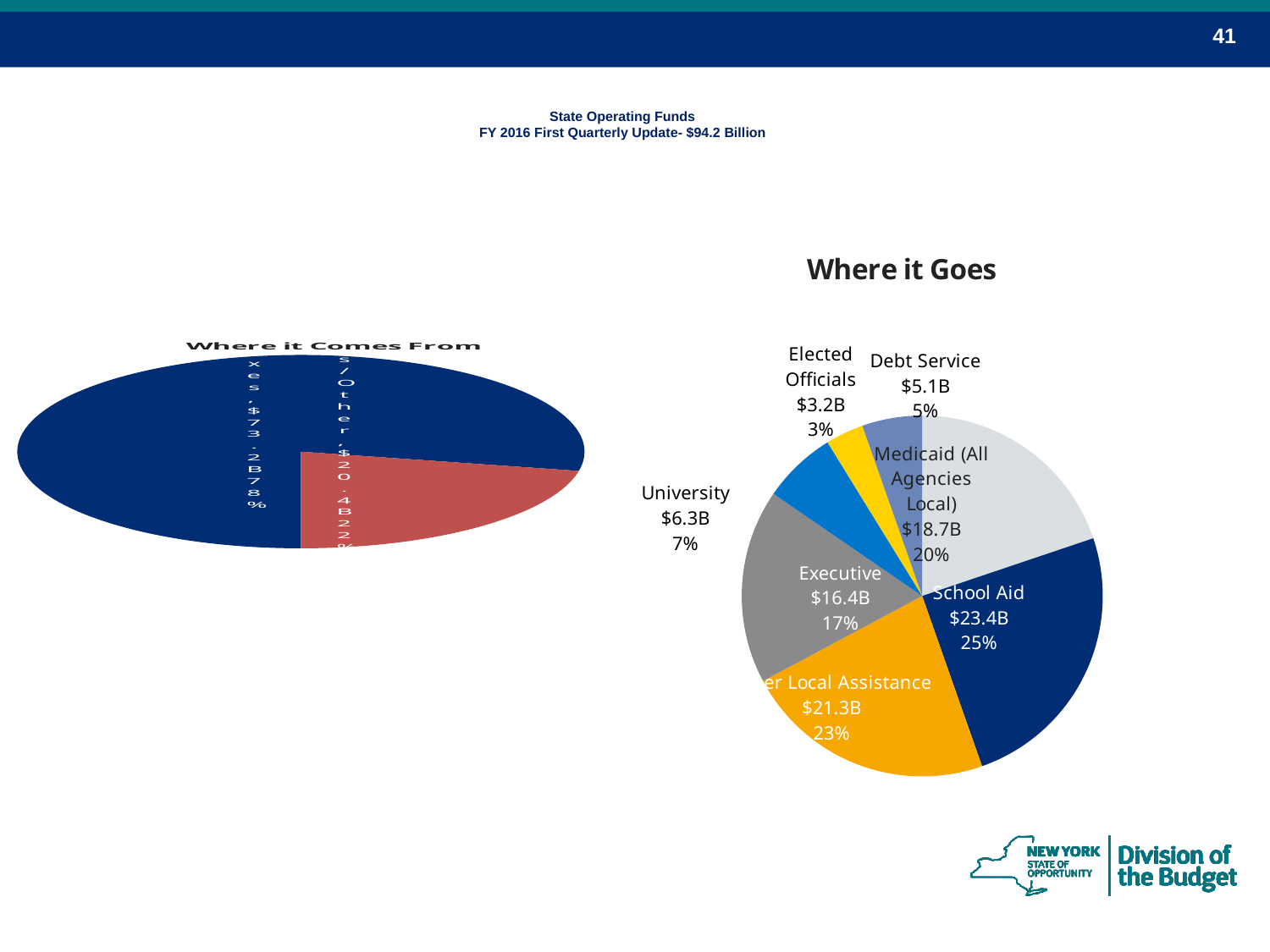
In the 'Where it Goes' chart, what is the value for School Aid? $23.4B In the 'Where it Goes' chart, what is the value for Debt Service? $5.1B In the 'Where it Goes' chart, which is larger, Executive or University? Executive In the 'Where it Goes' chart, which category has the smallest slice? Elected Officials In the 'Where it Goes' chart, how much larger is School Aid than Medicaid (All Agencies Local) in dollars? $4.7B How many slices does the 'Where it Goes' pie chart have? 7 What is the title of the pie chart on the left side of the slide? Where it Comes From In the 'Where it Goes' chart, what is the difference in percentage points between Executive and University? 10 percentage points In the 'Where it Goes' chart, which category has the largest slice? School Aid In the 'Where it Goes' chart, what percentage share does University have? 7% What kind of chart is the 'Where it Goes' chart? pie chart In the 'Where it Goes' chart, what percentage share does Medicaid (All Agencies Local) have? 20%